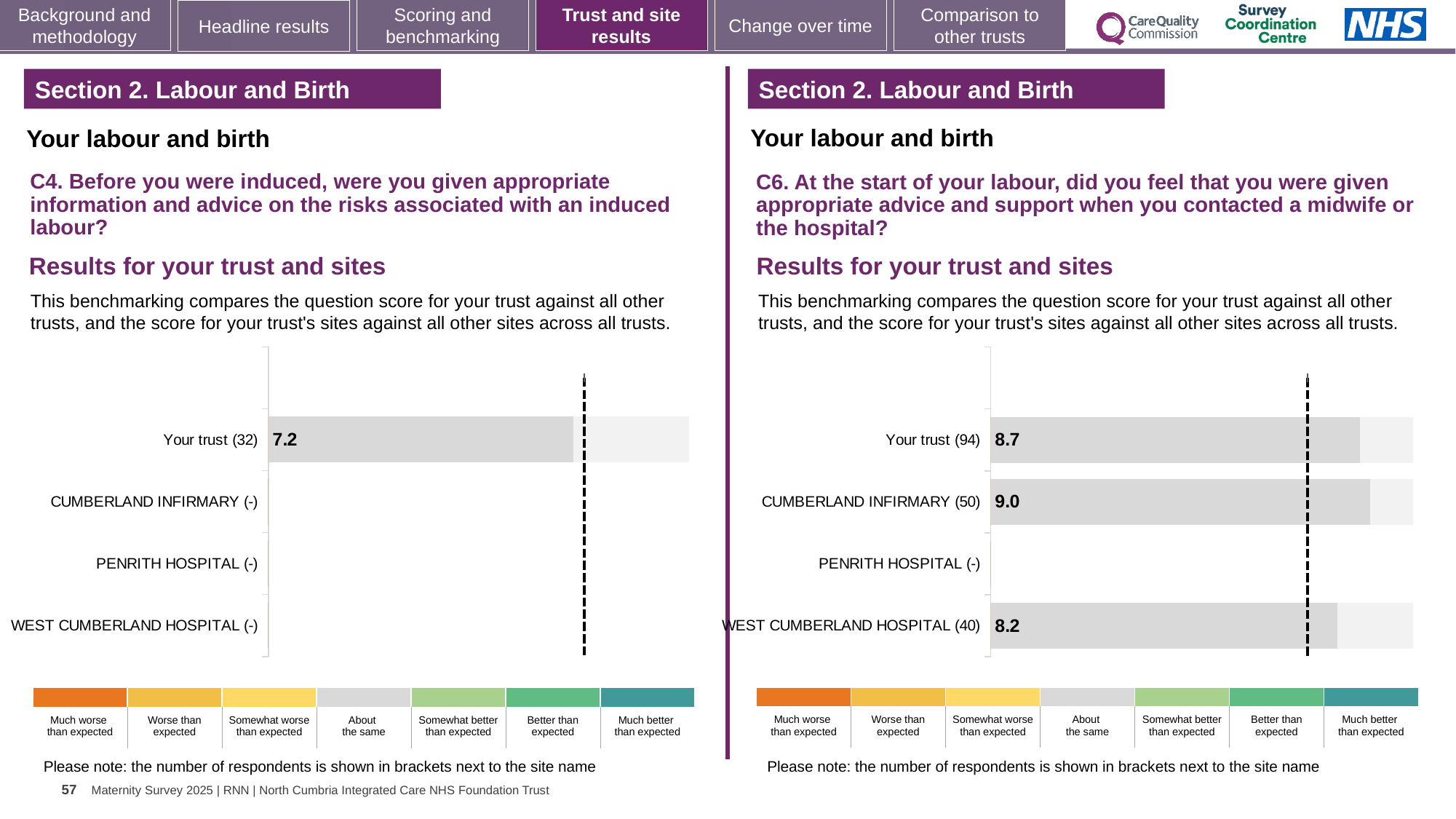
In the C6 chart on the right, how many respondents are shown in brackets for CUMBERLAND INFIRMARY? 50 How many categories are listed on the y axis of the C4 chart on the left? 4 In the C6 chart on the right, what is the score for WEST CUMBERLAND HOSPITAL? 8.2 In the C4 chart on the left, what is the score for Your trust? 7.2 In the C6 chart on the right, which site has the highest score? CUMBERLAND INFIRMARY In the C6 chart on the right, which is larger: the score for Your trust or the score for WEST CUMBERLAND HOSPITAL? Your trust In the C6 chart on the right, what is the score for CUMBERLAND INFIRMARY? 9.0 In the C4 chart on the left, how many respondents are shown in brackets for Your trust? 32 In the C6 chart on the right, which of the sites with a plotted score has the lowest score? WEST CUMBERLAND HOSPITAL In the C6 chart on the right, what is the difference between the scores for CUMBERLAND INFIRMARY and WEST CUMBERLAND HOSPITAL? 0.8 In the C6 chart on the right, what is the score for Your trust? 8.7 What kind of chart is the C6 chart on the right? Bar chart